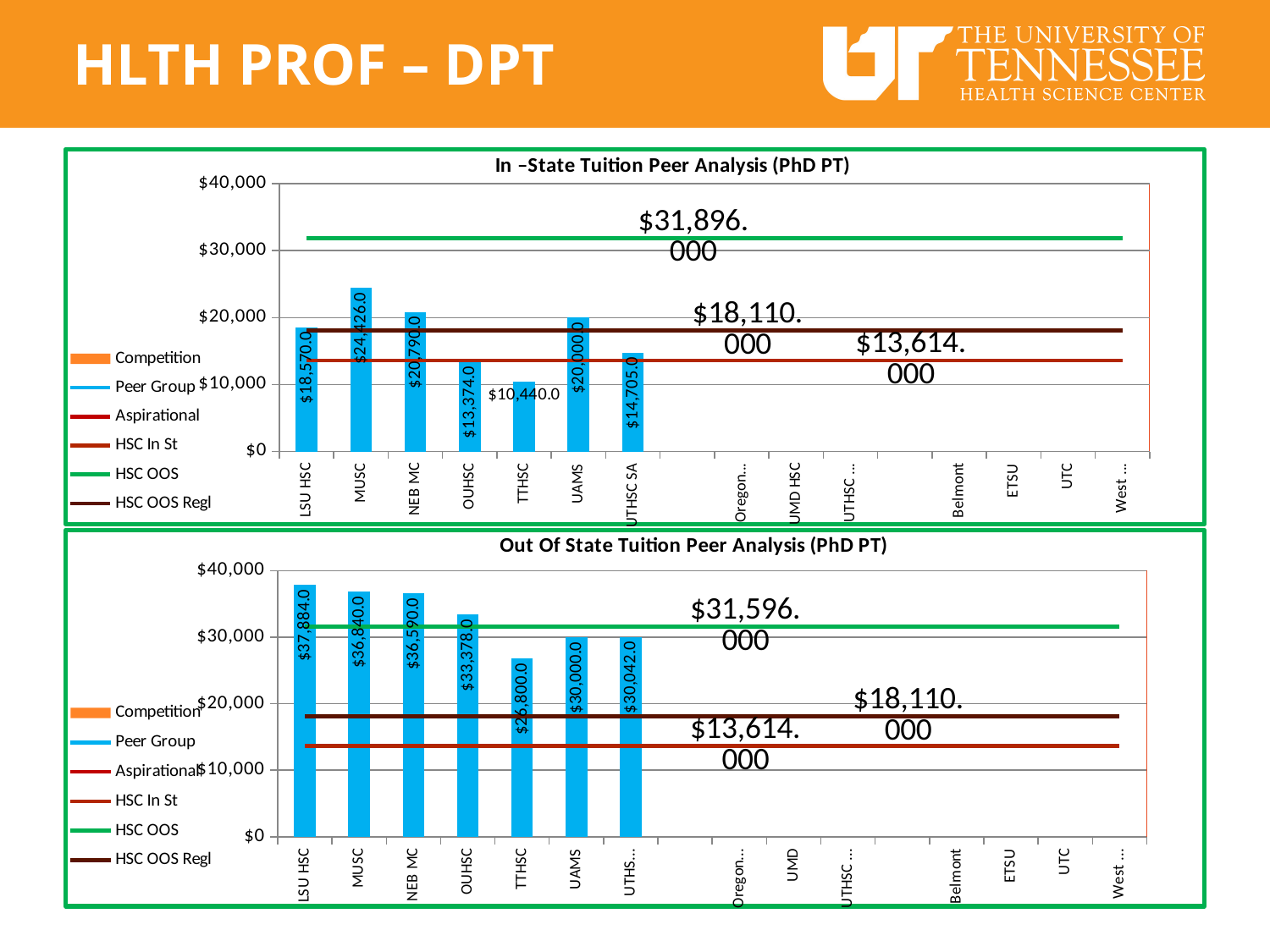
In the In-State Tuition Peer Analysis chart, what value is labelled on the HSC OOS line? $31,896.000 In the In-State Tuition Peer Analysis chart, what is the value for MUSC? $24,426.0 In the In-State Tuition Peer Analysis chart, which peer has the highest tuition bar? MUSC In the Out Of State Tuition Peer Analysis chart, is the value for TTHSC greater or less than $30,000? less In the Out Of State Tuition Peer Analysis chart, what is the value for LSU HSC? $37,884.0 In the In-State Tuition Peer Analysis chart, what is the difference between the NEB MC and UAMS values? $790.0 In the Out Of State Tuition Peer Analysis chart, which peer has the lowest tuition bar? TTHSC What kind of chart is the Out Of State Tuition Peer Analysis chart? Bar chart In the In-State Tuition Peer Analysis chart, which peer has the lowest tuition bar? TTHSC In the Out Of State Tuition Peer Analysis chart, what is the difference between the LSU HSC and TTHSC values? $11,084.0 In the Out Of State Tuition Peer Analysis chart, which is larger, the value for MUSC or the value for OUHSC? MUSC How many entries does the legend of the In-State Tuition Peer Analysis chart list? 6